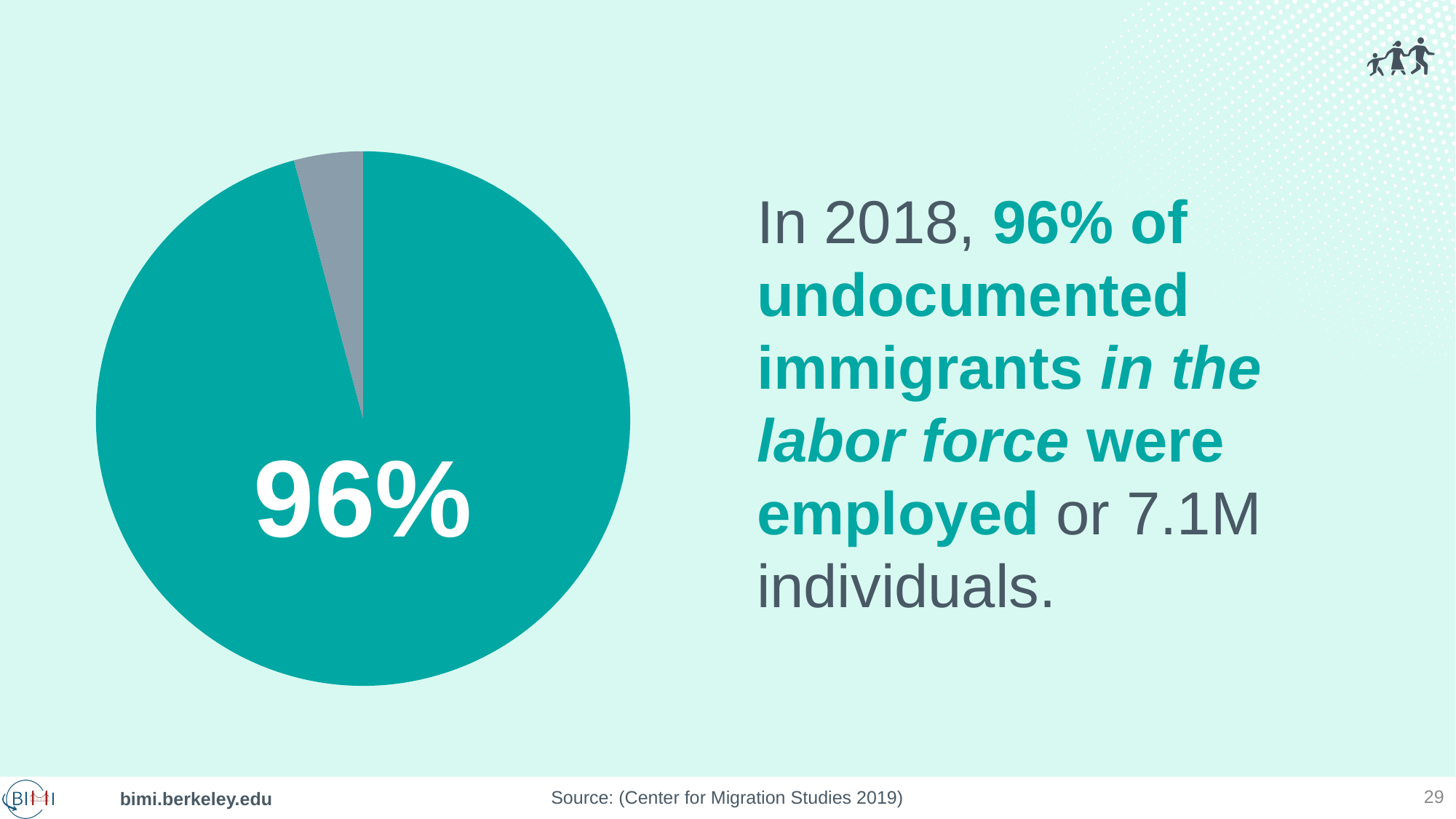
Which slice of the pie chart is the smallest? gray slice What share of the pie does the teal slice represent? 96% What colour is the slice labelled 96% in the pie chart? teal What percentage is printed on the large teal slice of the pie chart? 96% What kind of chart is shown on the slide? pie chart How many slices does the pie chart have? 2 Which slice of the pie chart is larger, the teal slice or the gray slice? teal slice According to the slide text, how many undocumented immigrants in the labor force were employed in 2018? 7.1M